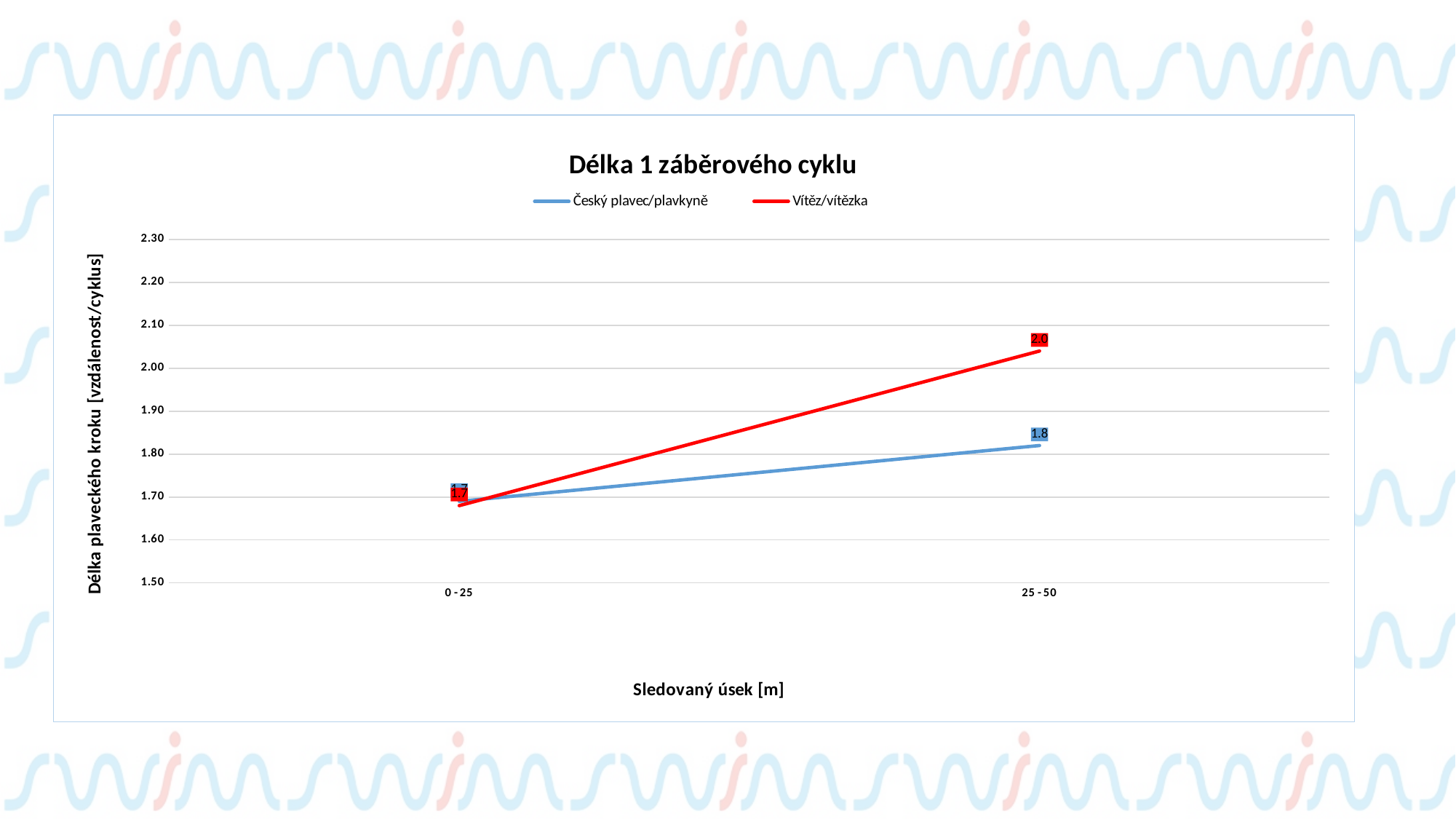
In the 25 - 50 section, which series has the higher value, Český plavec/plavkyně or Vítěz/vítězka? Vítěz/vítězka Is the value for Vítěz/vítězka in the 25 - 50 section greater or less than 1.90? greater How many categories are shown on the x axis? 2 What colour is the line for Vítěz/vítězka? red What kind of chart is shown on the slide? line chart What is the value for Vítěz/vítězka in the 25 - 50 section? 2.0 What is the value for Český plavec/plavkyně in the 25 - 50 section? 1.8 How many series does the legend list? 2 What is the difference between the Vítěz/vítězka and Český plavec/plavkyně values in the 25 - 50 section? 0.2 What is the value for Český plavec/plavkyně in the 0 - 25 section? 1.7 Does the value for Vítěz/vítězka rise or fall from the 0 - 25 section to the 25 - 50 section? rise What is the title of the x axis? Sledovaný úsek [m]